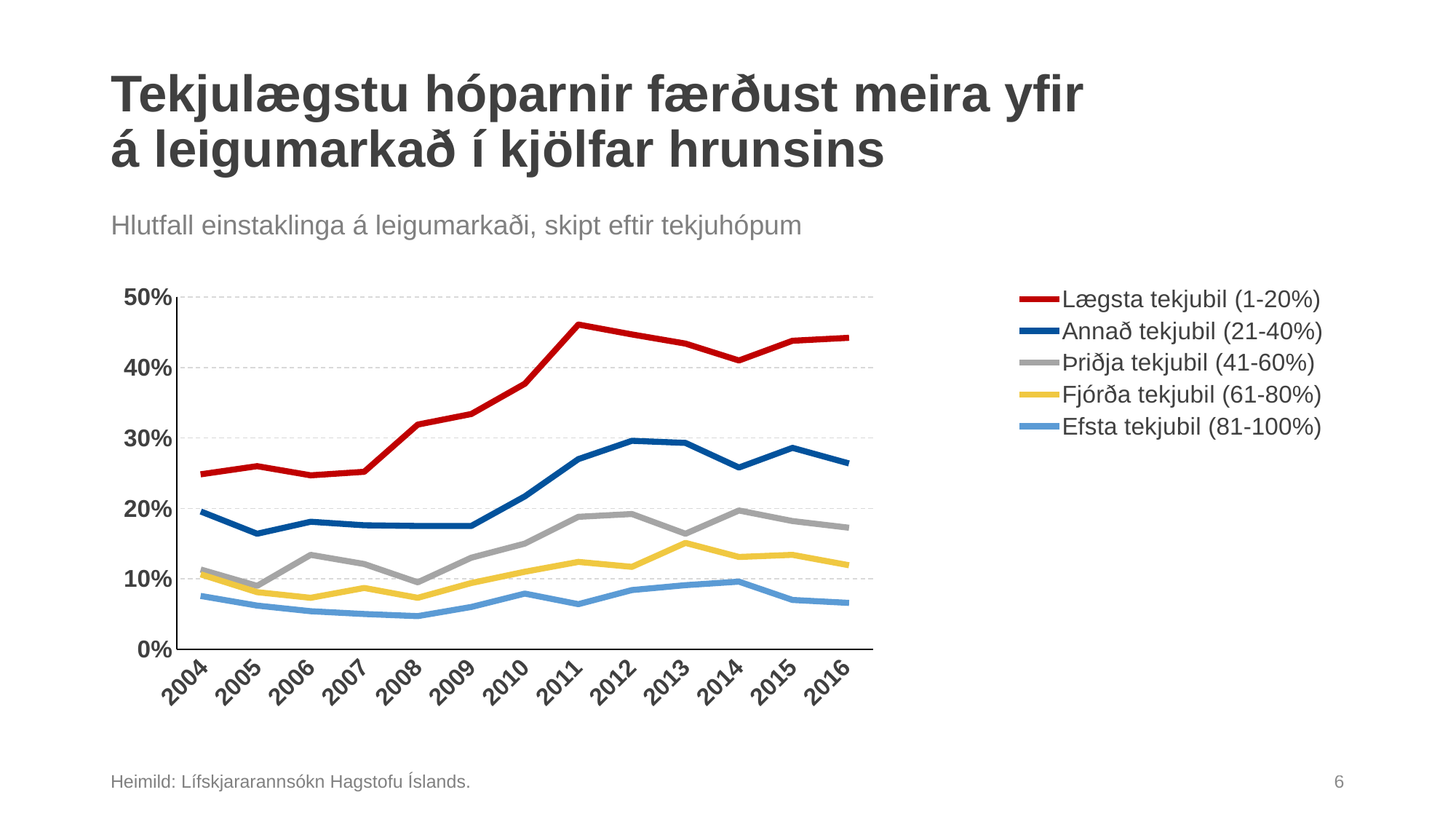
Which series has the highest value in 2016? Lægsta tekjubil (1-20%) What kind of chart is shown on the slide? Line chart Which series has the lowest value in 2016? Efsta tekjubil (81-100%) Is the value for Efsta tekjubil (81-100%) in 2016 greater or less than 10%? less Is the value for Annað tekjubil (21-40%) in 2005 greater or less than 20%? less How many series does the legend list? 5 In which year does Lægsta tekjubil (1-20%) reach its highest value? 2011 Does the value for Lægsta tekjubil (1-20%) rise or fall from 2007 to 2011? rise How many years are plotted along the x axis? 13 Is the value for Fjórða tekjubil (61-80%) in 2013 greater or less than 10%? greater In 2006, which is larger: Þriðja tekjubil (41-60%) or Fjórða tekjubil (61-80%)? Þriðja tekjubil (41-60%)